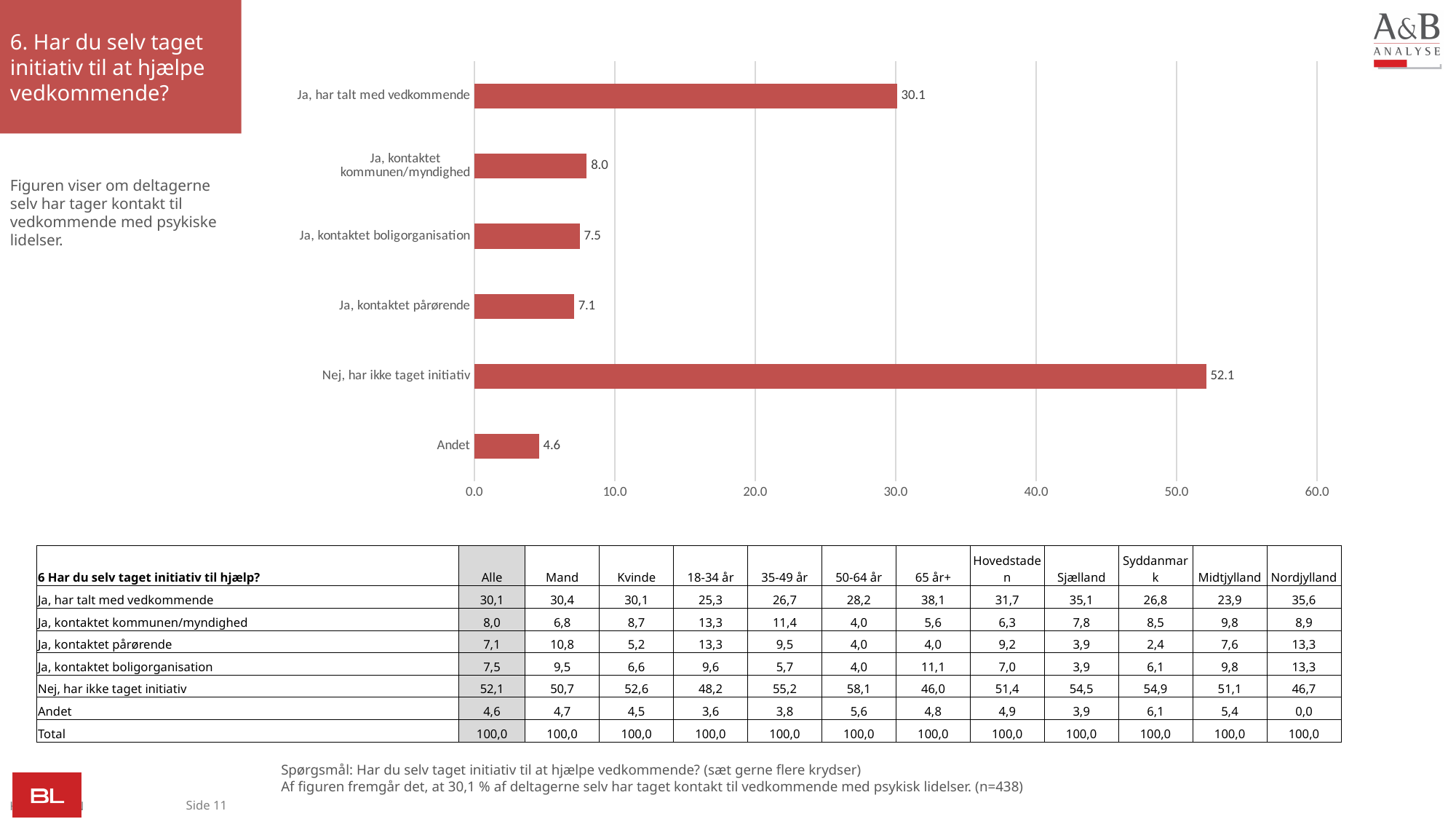
What is the value for "Nej, har ikke taget initiativ"? 52.1 What is the difference between "Nej, har ikke taget initiativ" and "Ja, har talt med vedkommende"? 22.0 Which category has the lowest value? Andet What is the value for "Andet"? 4.6 Is the value for "Nej, har ikke taget initiativ" greater or less than 50.0? greater What is the highest value shown on the x axis? 60.0 Which category has the highest value? Nej, har ikke taget initiativ Which is larger, "Ja, kontaktet boligorganisation" or "Ja, kontaktet pårørende"? Ja, kontaktet boligorganisation How many categories are shown in the chart? 6 What kind of chart is shown on the slide? bar chart What is the value for "Ja, kontaktet kommunen/myndighed"? 8.0 What is the value for "Ja, har talt med vedkommende"? 30.1